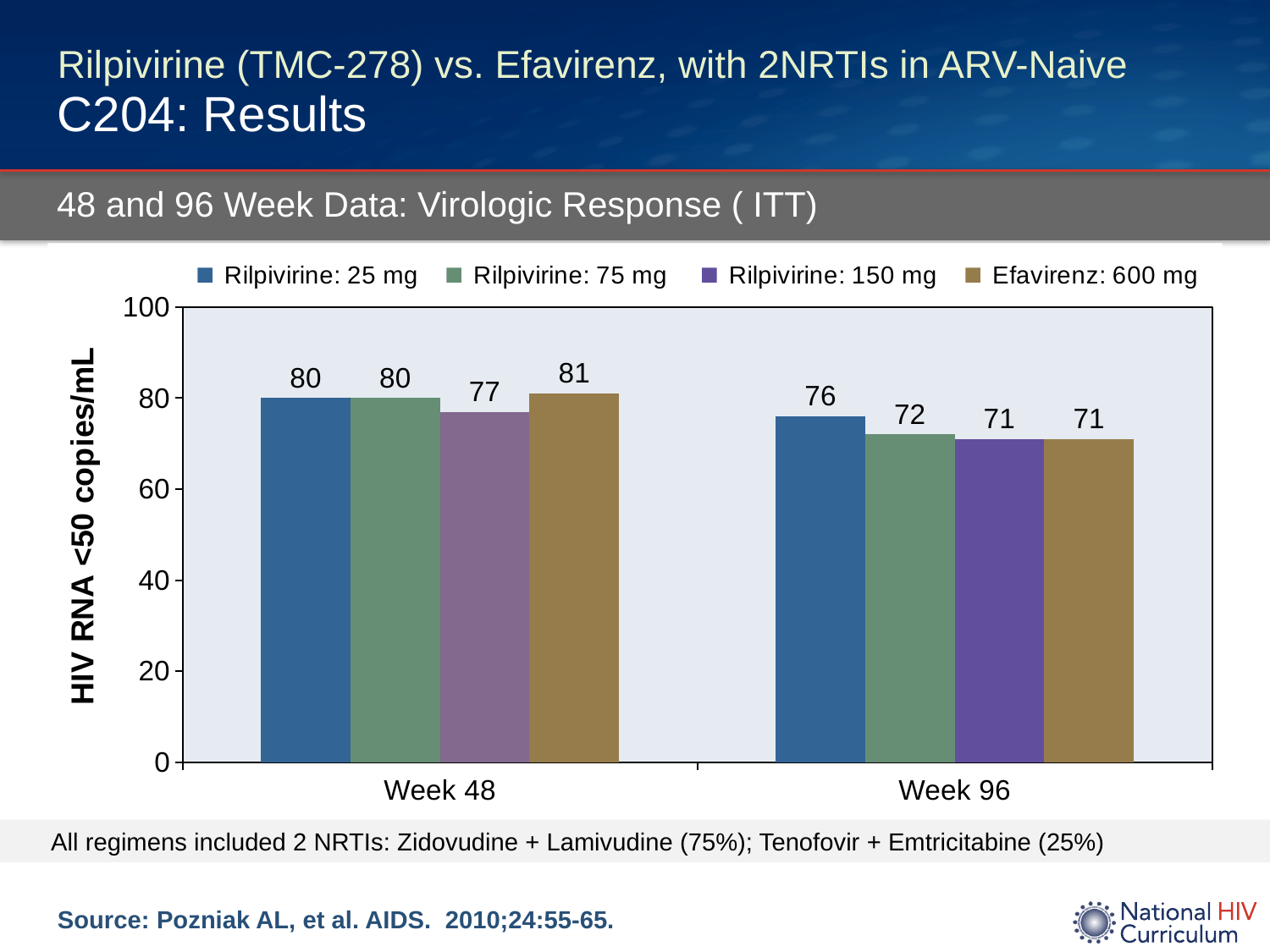
How many series does the legend list? 4 Which is larger at Week 96: Rilpivirine: 25 mg or Rilpivirine: 75 mg? Rilpivirine: 25 mg What is the difference between Efavirenz: 600 mg and Rilpivirine: 150 mg at Week 48? 4 What is the value for Rilpivirine: 150 mg at Week 48? 77 Do the values for Rilpivirine: 75 mg rise or fall from Week 48 to Week 96? Fall What is the value for Rilpivirine: 25 mg at Week 48? 80 What is the value for Rilpivirine: 75 mg at Week 96? 72 What kind of chart is shown on the slide? Bar chart Which series has the highest value at Week 48? Efavirenz: 600 mg What is the value for Efavirenz: 600 mg at Week 96? 71 Which series has the highest value at Week 96? Rilpivirine: 25 mg What is the difference between the Rilpivirine: 25 mg values at Week 48 and Week 96? 4